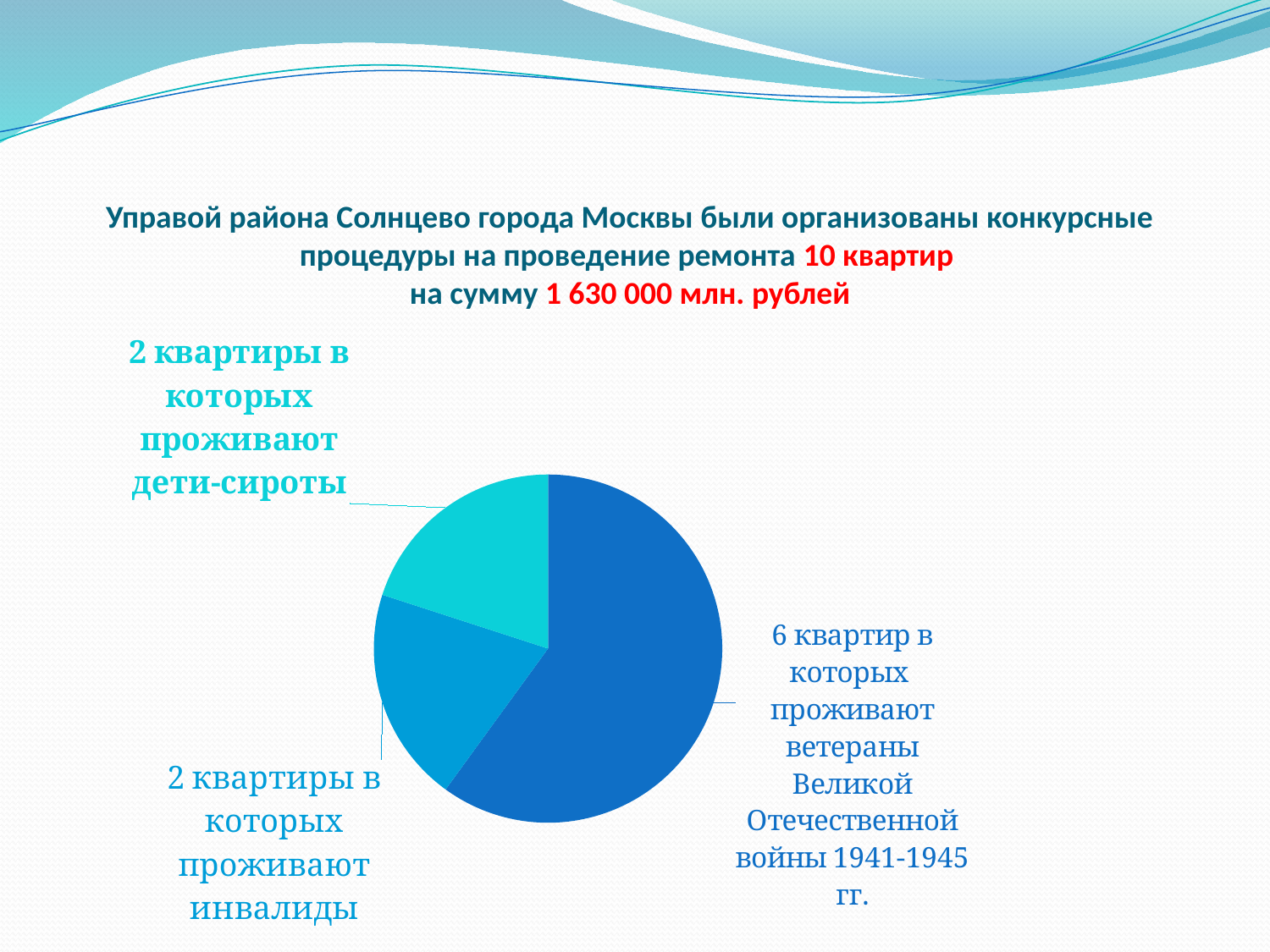
What is the total number of apartments represented in the pie chart? 10 How many apartments in the pie chart are ones where disabled people (инвалиды) live? 2 What share of the pie do the apartments for orphans represent? 20% How many apartments in the pie chart are ones where veterans of the Great Patriotic War 1941-1945 live? 6 Which category has the largest slice of the pie chart? 6 квартир в которых проживают ветераны Великой Отечественной войны 1941-1945 гг. What share of the pie do the apartments for war veterans represent? 60% Which is larger: the number of apartments for war veterans or the number of apartments for disabled people? apartments for war veterans What colour is the slice for the apartments where war veterans live? dark blue How many apartments in the pie chart are ones where orphans (дети-сироты) live? 2 What kind of chart is shown on the slide? pie chart What is the difference between the number of apartments for war veterans and the number of apartments for orphans? 4 How many slices does the pie chart have? 3